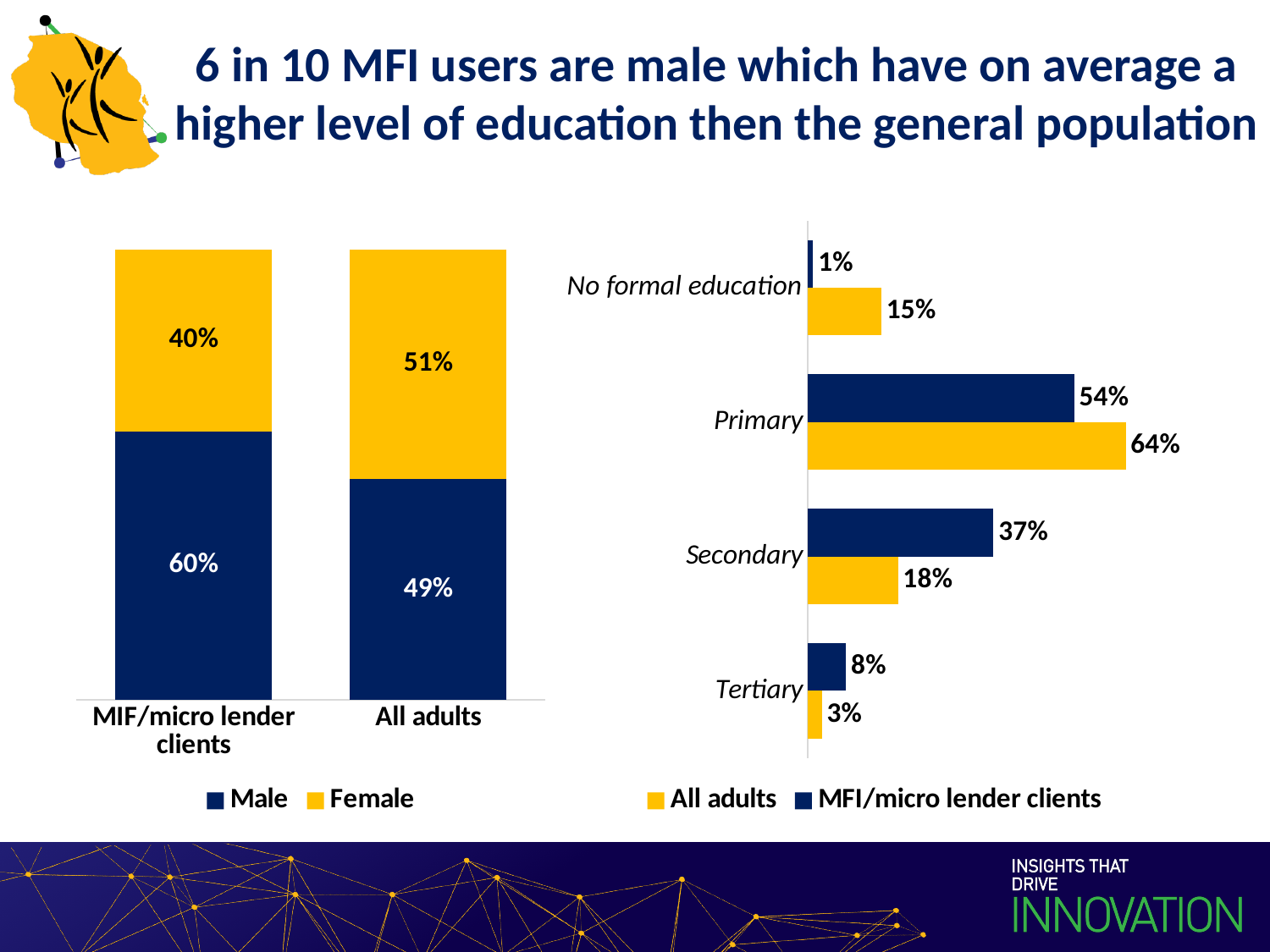
In the right chart, which is larger for secondary education: all adults or MFI/micro lender clients? MFI/micro lender clients In the left chart, what percentage of MIF/micro lender clients are male? 60% In the left chart, what percentage of all adults are female? 51% In the right chart, what percentage of all adults have no formal education? 15% In the left chart, how many series does the legend list? 2 In the left chart, what is the total of the stacked bar for All adults? 100% In the right chart, which education level has the lowest value for MFI/micro lender clients? No formal education In the right chart, what is the difference between all adults and MFI/micro lender clients for tertiary education? 5% In the right chart, which education level has the highest value for all adults? Primary In the left chart, what is the difference between the male share of MIF/micro lender clients and the male share of all adults? 11% What kind of chart is the right chart? Bar chart In the right chart, what percentage of MFI/micro lender clients have primary education? 54%